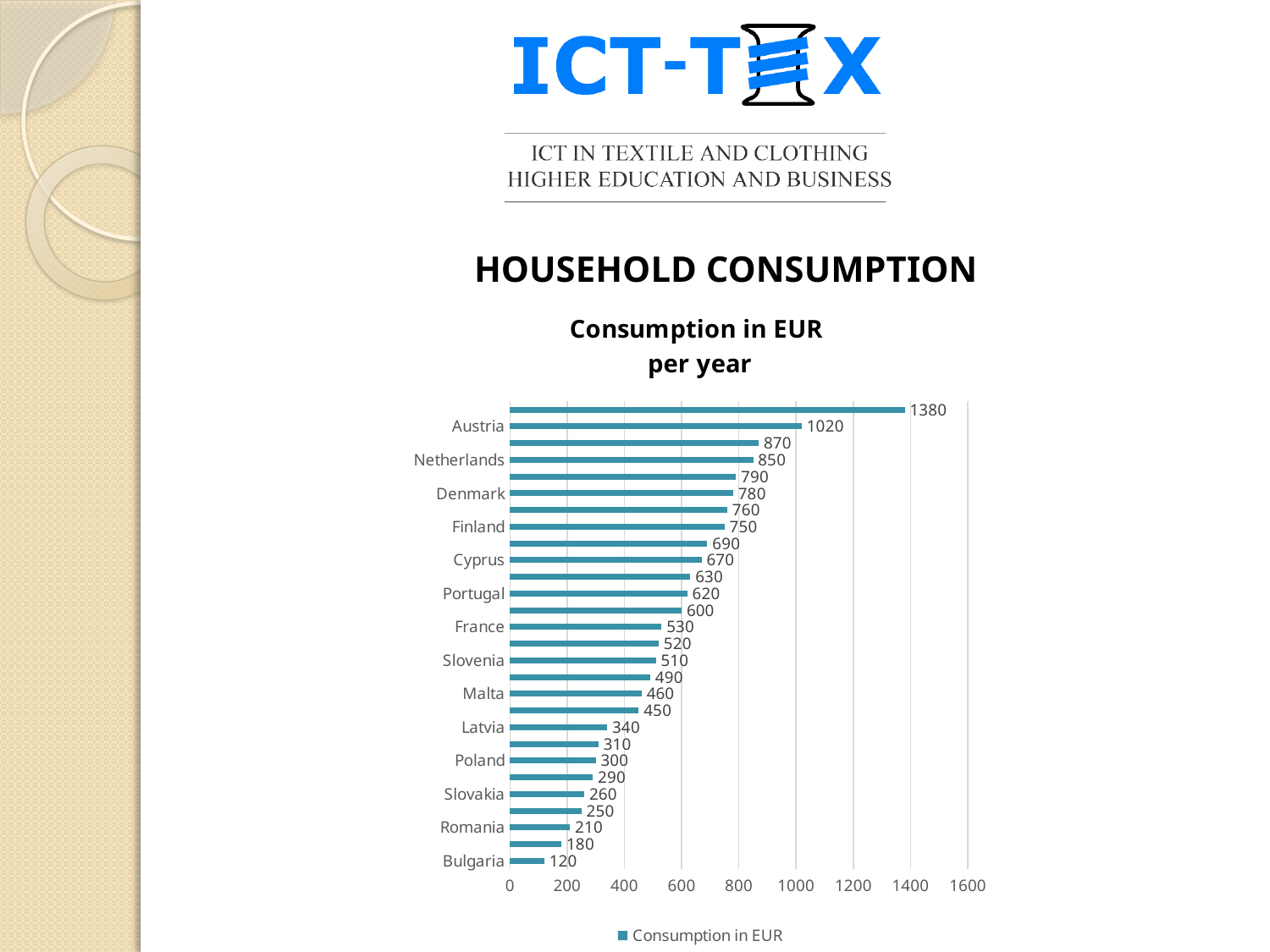
Which labelled country has the lowest consumption? Bulgaria What kind of chart is shown on the slide? Bar chart What is the difference between the values for Austria and Bulgaria? 900 What is the difference between the values for Denmark and Finland? 30 What is the value shown for Poland? 300 How many bars are plotted in the chart? 28 What is the value shown for the Netherlands? 850 What is the value shown for Bulgaria? 120 Is the value for Latvia greater or less than 400? less What is the consumption in EUR per year for Austria? 1020 Which has a higher value, Cyprus or Portugal? Cyprus What is the legend entry shown below the chart? Consumption in EUR